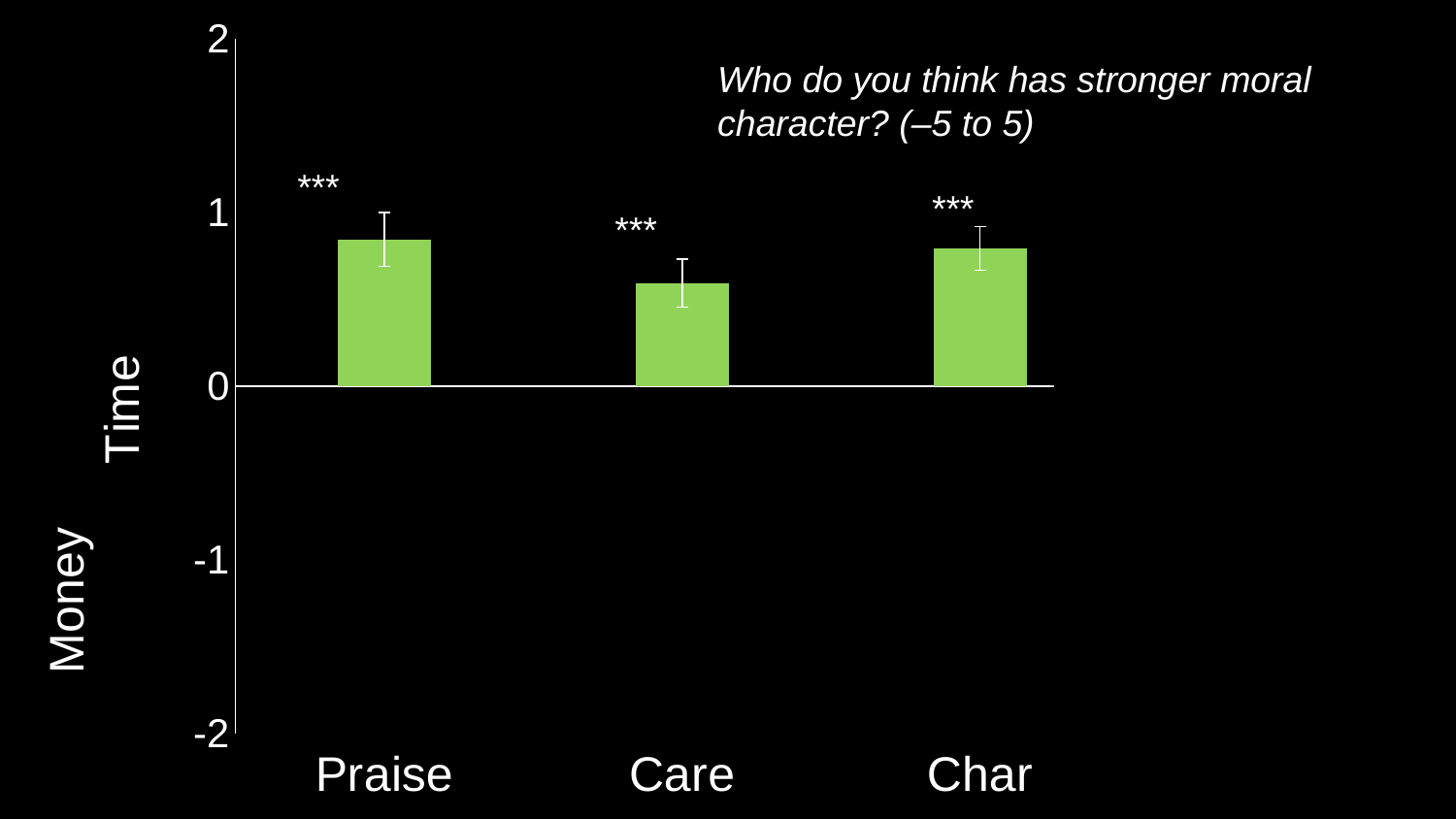
Is the value for Care greater or less than 0? greater Are all three bars in the chart positive or negative? positive How many categories are shown on the x axis of the chart? 3 Which is larger, the value for Char or the value for Care? Char Which category has the lowest bar in the chart? Care Is the value for Praise greater or less than 1? less What kind of chart is shown on the slide? bar chart Is the value for Care greater or less than 1? less Which is larger, the value for Praise or the value for Care? Praise What colour are the bars in the chart? green What question is written in italics at the top of the chart? Who do you think has stronger moral character? (–5 to 5)